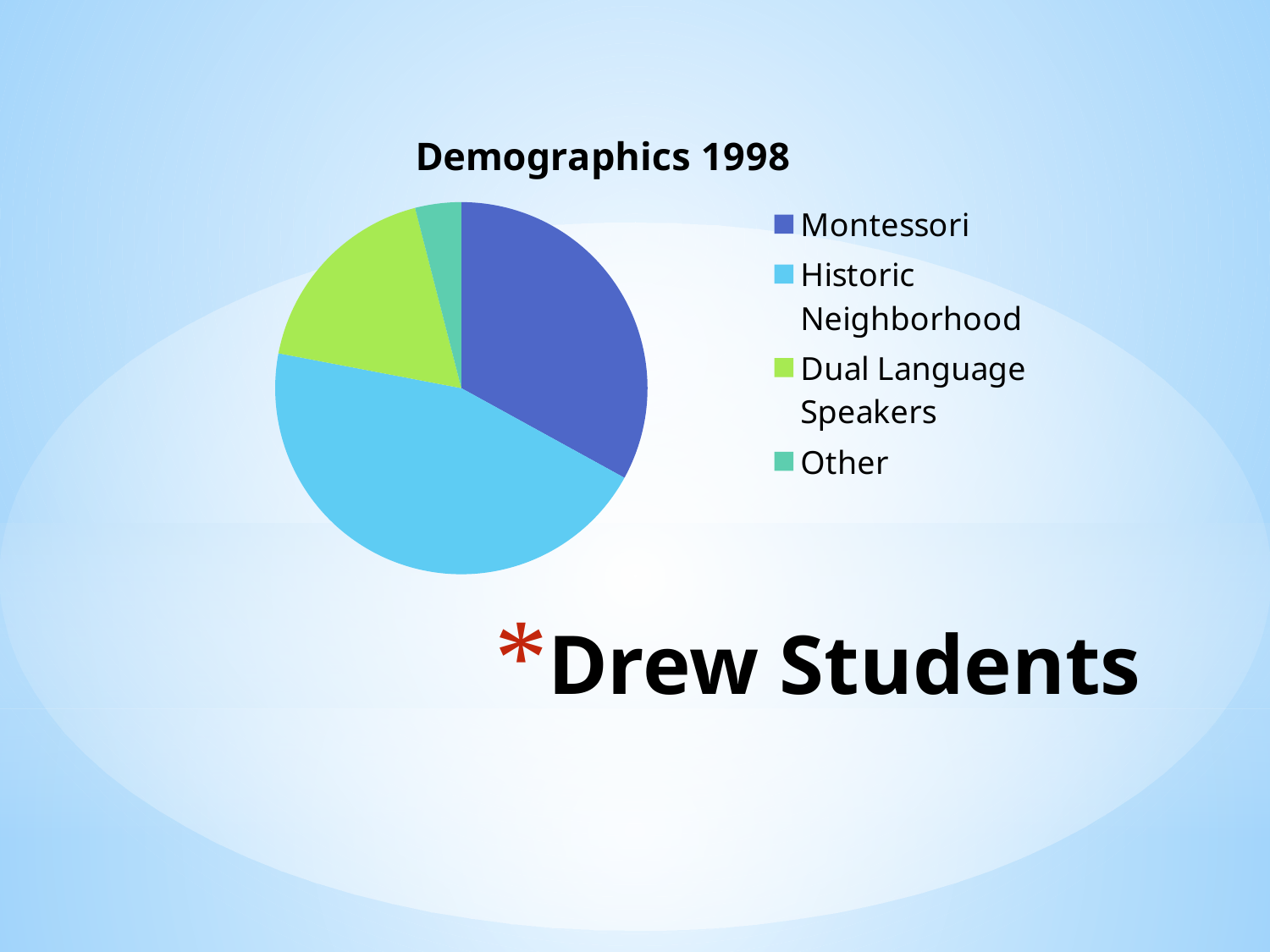
Which category is shown in the light green colour? Dual Language Speakers Which slice is larger, Dual Language Speakers or Other? Dual Language Speakers What is the title of the chart? Demographics 1998 Which category has the largest slice of the pie? Historic Neighborhood What kind of chart is shown on the slide? Pie chart How many slices does the pie chart have? 4 How many entries does the legend list? 4 Which slice is larger, Montessori or Dual Language Speakers? Montessori Which category has the smallest slice of the pie? Other Which slice is larger, Historic Neighborhood or Montessori? Historic Neighborhood